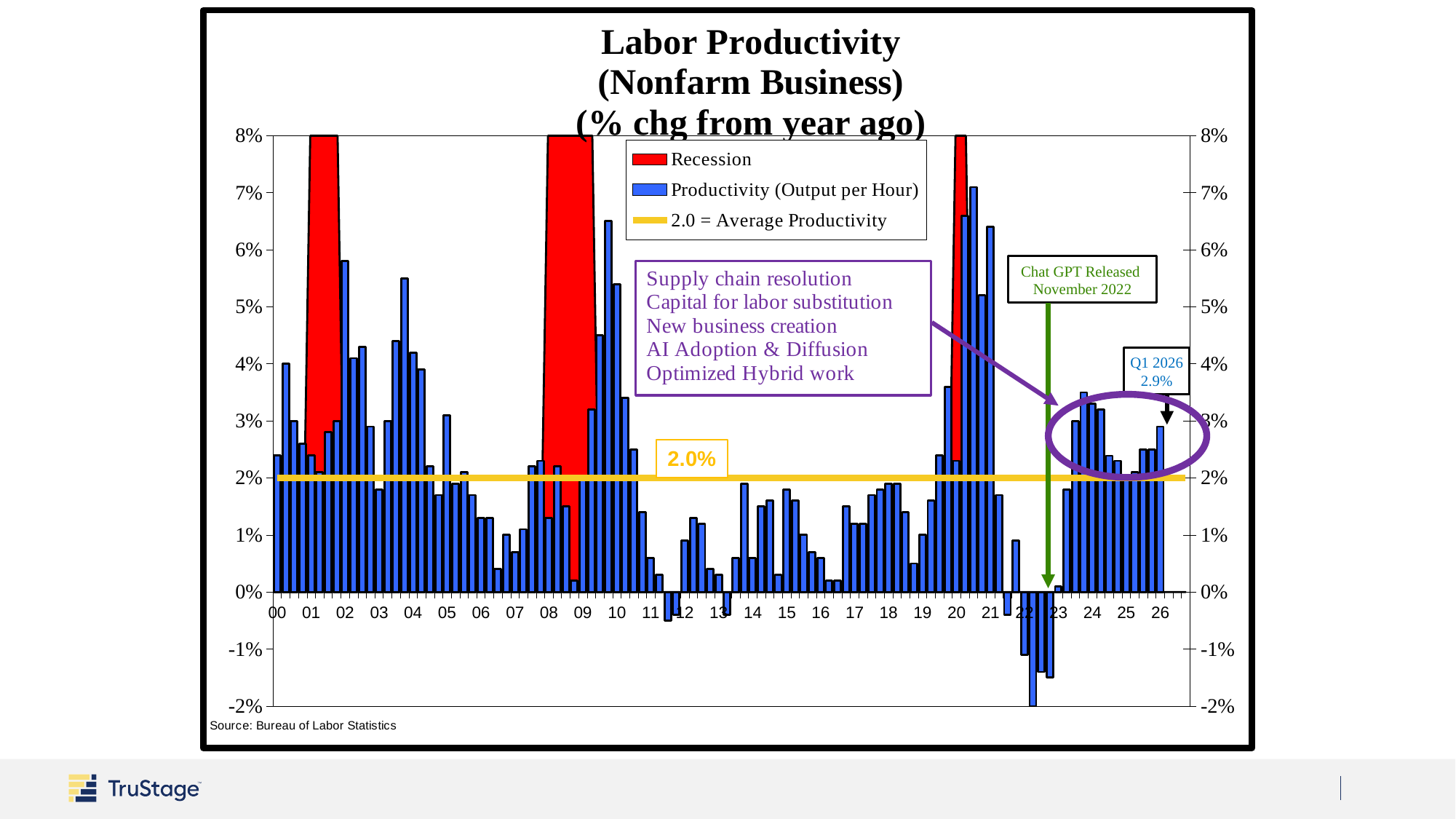
Is the Q1 2026 productivity value above or below the 2.0% average line? above Is the peak productivity bar around 2009-2010 greater or less than 5%? greater What value does the yellow horizontal line representing average productivity mark? 2.0% What is the first year label and the last year label on the x axis? 00 and 26 Is the tallest blue productivity bar, around 2021, greater or less than 6%? greater What is the labor productivity value annotated for Q1 2026? 2.9% Is the lowest productivity bar, around 2022, greater or less than -1%? less What event does the green annotation say occurred in November 2022? Chat GPT Released How many entries does the legend list? 3 What kind of chart is shown on the slide? bar chart What is the title of the chart? Labor Productivity (Nonfarm Business) (% chg from year ago) How many red recession periods are shaded on the chart? 3